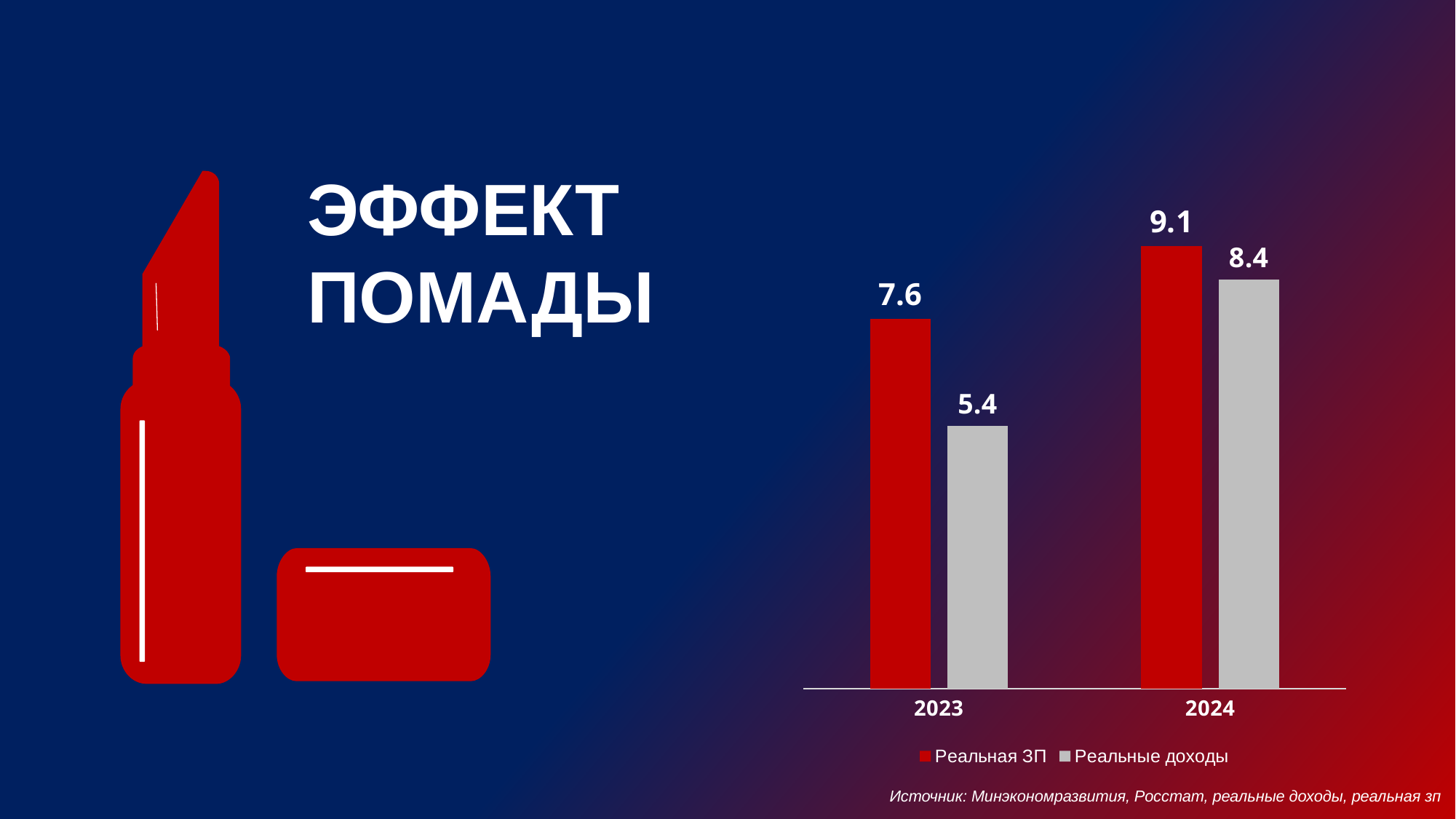
Which year has the highest value for Реальная ЗП? 2024 What kind of chart is shown on the slide? Bar chart Which is larger in 2024: Реальная ЗП or Реальные доходы? Реальная ЗП How many series does the legend list? 2 What is the value of Реальные доходы for 2023? 5.4 What is the value of Реальные доходы for 2024? 8.4 Which year has the lowest value for Реальные доходы? 2023 By how much did Реальные доходы increase from 2023 to 2024? 3.0 What is the difference between Реальная ЗП and Реальные доходы in 2023? 2.2 What is the value of Реальная ЗП for 2023? 7.6 What is the value of Реальная ЗП for 2024? 9.1 Do the values for Реальная ЗП rise or fall from 2023 to 2024? Rise